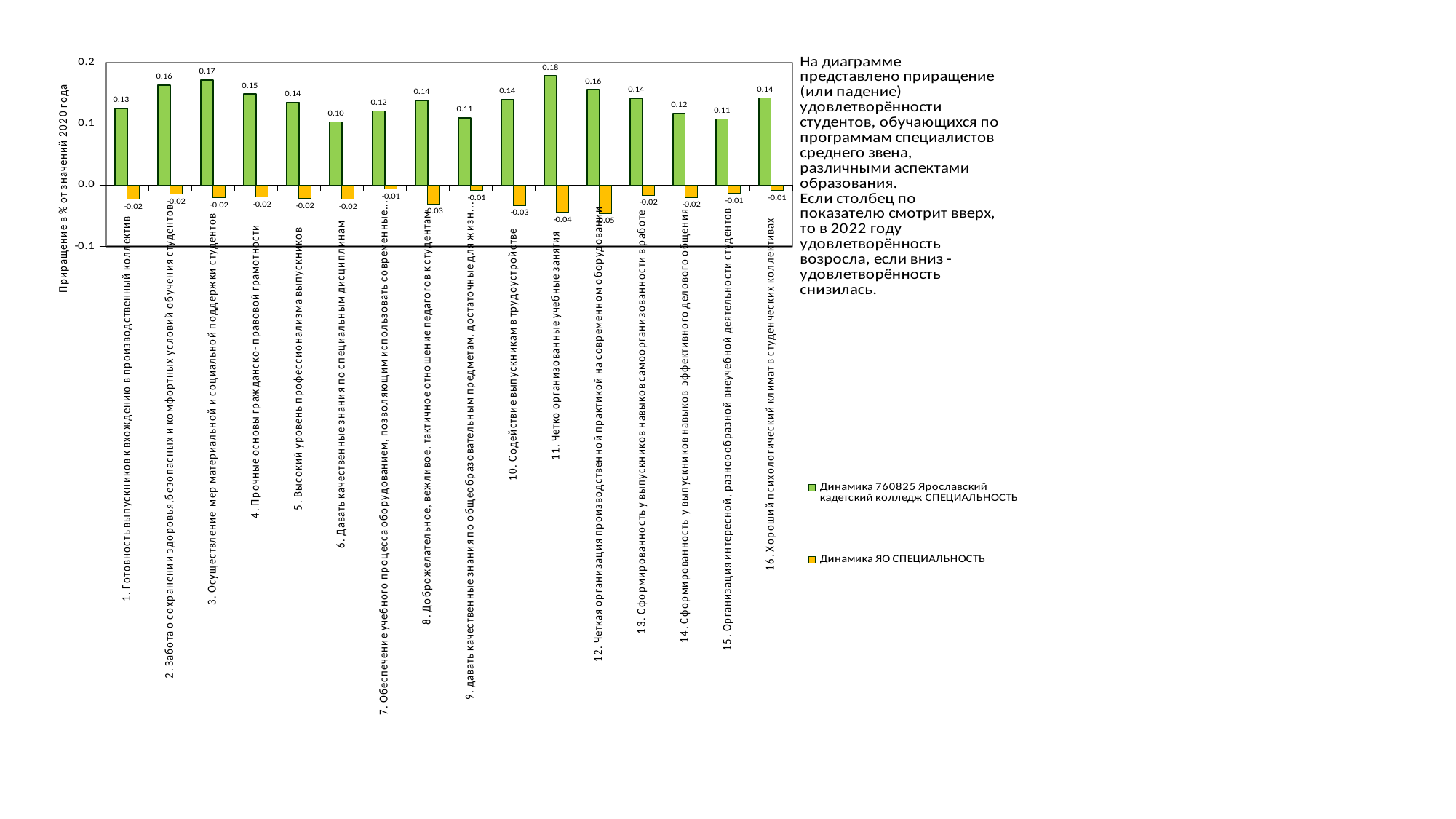
What colour are the bars for the series "Динамика ЯО СПЕЦИАЛЬНОСТЬ"? yellow Which is larger for the series "Динамика 760825 Ярославский кадетский колледж СПЕЦИАЛЬНОСТЬ": category 2 (Забота о сохранении здоровья...) or category 9 (давать качественные знания по общеобразовательным предметам...)? category 2 Which category has the lowest value for the series "Динамика 760825 Ярославский кадетский колледж СПЕЦИАЛЬНОСТЬ"? 6. Давать качественные знания по специальным дисциплинам What is the difference between the green series values for category 3 (Осуществление мер материальной и социальной поддержки студентов) and category 6 (Давать качественные знания по специальным дисциплинам)? 0.07 How many series does the legend list? 2 Which category has the lowest value for the series "Динамика ЯО СПЕЦИАЛЬНОСТЬ"? 12. Четкая организация производственной практикой на современном оборудовании How many categories are plotted along the x axis? 16 Is the value of the green series for category "4. Прочные основы гражданско-правовой грамотности" greater or less than 0.1? greater What is the value of the series "Динамика ЯО СПЕЦИАЛЬНОСТЬ" for category "12. Четкая организация производственной практикой на современном оборудовании"? -0.05 What type of chart is shown on the slide? bar chart Which category has the highest value for the series "Динамика 760825 Ярославский кадетский колледж СПЕЦИАЛЬНОСТЬ"? 11. Четко организованные учебные занятия What is the value of the series "Динамика 760825 Ярославский кадетский колледж СПЕЦИАЛЬНОСТЬ" for category "11. Четко организованные учебные занятия"? 0.18